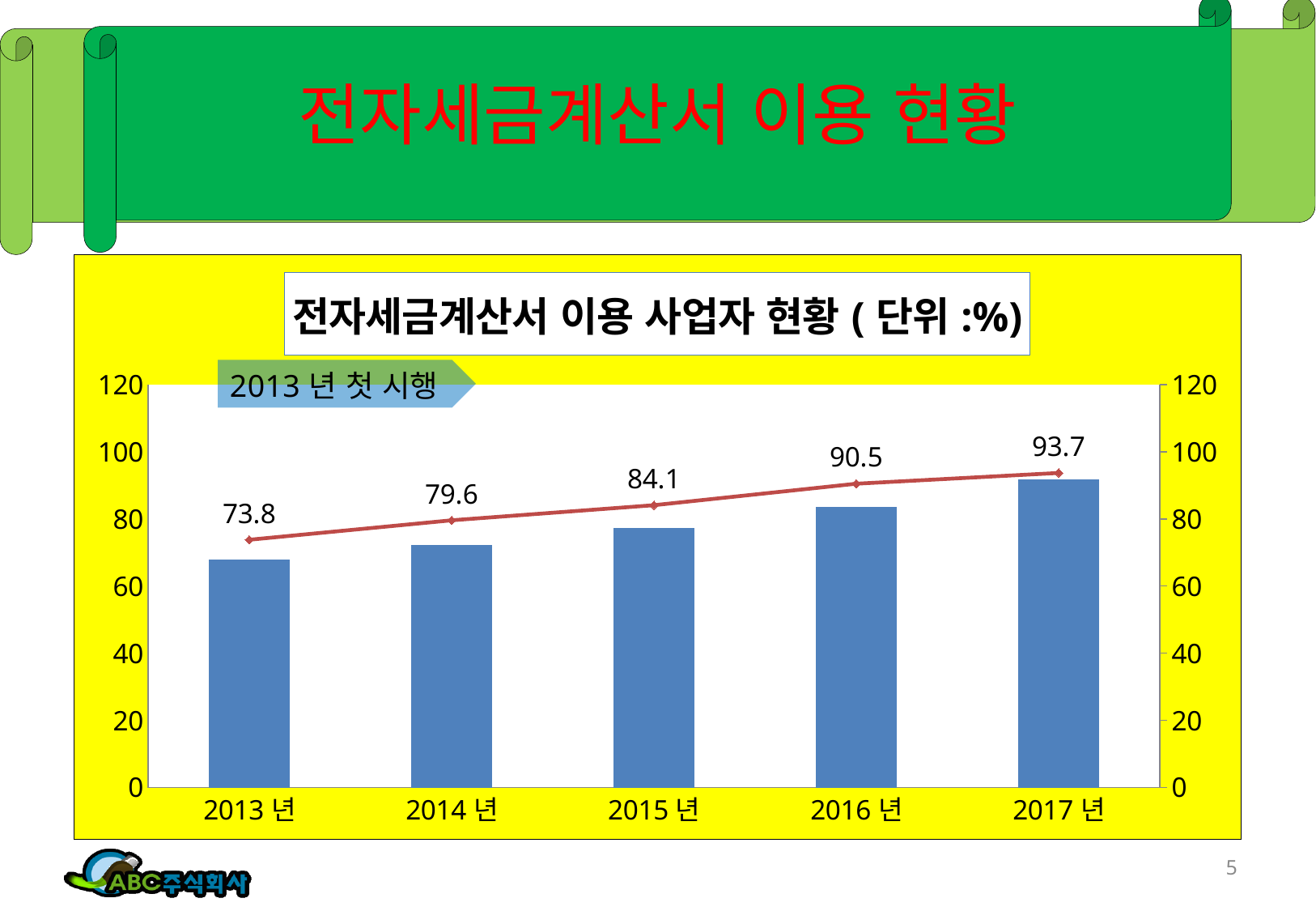
Which has the larger labelled value, 2014 년 or 2016 년? 2016 년 How many years are shown on the x axis? 5 What value is labelled on the line for 2013 년? 73.8 Which year has the highest labelled value on the line? 2017 년 Do the labelled values rise or fall from 2013 년 to 2017 년? rise What is the difference between the labelled values for 2017 년 and 2013 년? 19.9 Is the bar for 2013 년 greater or less than 80? less Is the bar for 2017 년 greater or less than 80? greater What is the title of the chart? 전자세금계산서 이용 사업자 현황 ( 단위 :%) Which year has the lowest labelled value on the line? 2013 년 What value is labelled on the line for 2015 년? 84.1 What value is labelled on the line for 2017 년? 93.7